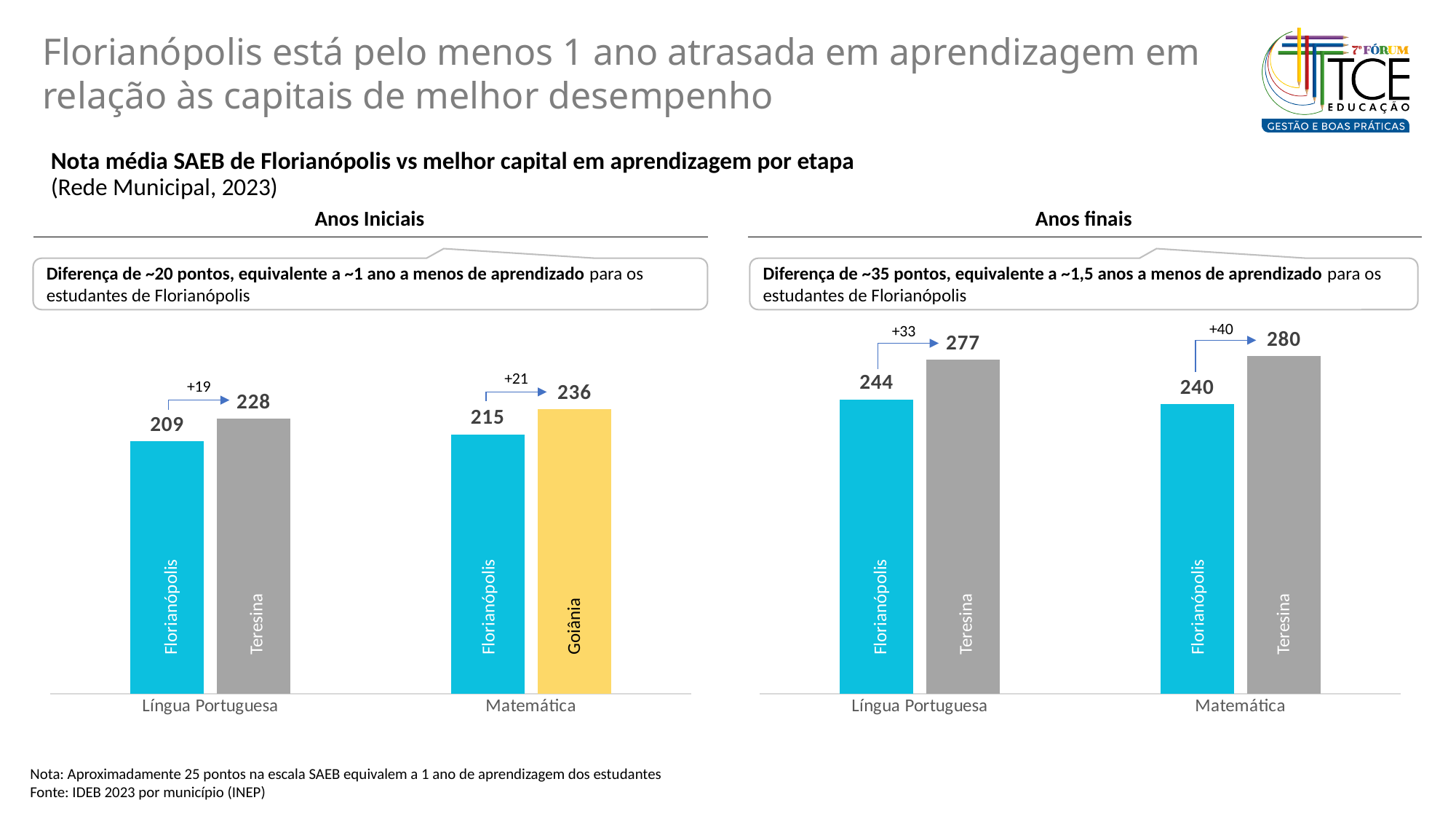
In the Anos Iniciais chart, what is the difference between Teresina and Florianópolis in Língua Portuguesa? 19 In the Anos Iniciais chart, what is the SAEB score for Florianópolis in Língua Portuguesa? 209 In the Anos Iniciais chart, which city is the best-performing capital in Matemática? Goiânia How many bars are plotted in the Anos finais chart? 4 In the Anos finais chart, what is the score for Florianópolis in Matemática? 240 In the Anos Iniciais chart, which bar has the lowest value? Florianópolis (Língua Portuguesa) In the Anos finais chart, what is the difference between Teresina and Florianópolis in Matemática? 40 What type of chart is used for Anos Iniciais? Bar chart In the Anos Iniciais chart, what is the score for Goiânia in Matemática? 236 In the Anos finais chart, what is the score for Teresina in Língua Portuguesa? 277 In the Anos Iniciais chart, which is larger in Matemática: Florianópolis or Goiânia? Goiânia In the Anos finais chart, which bar has the highest value? Teresina (Matemática)